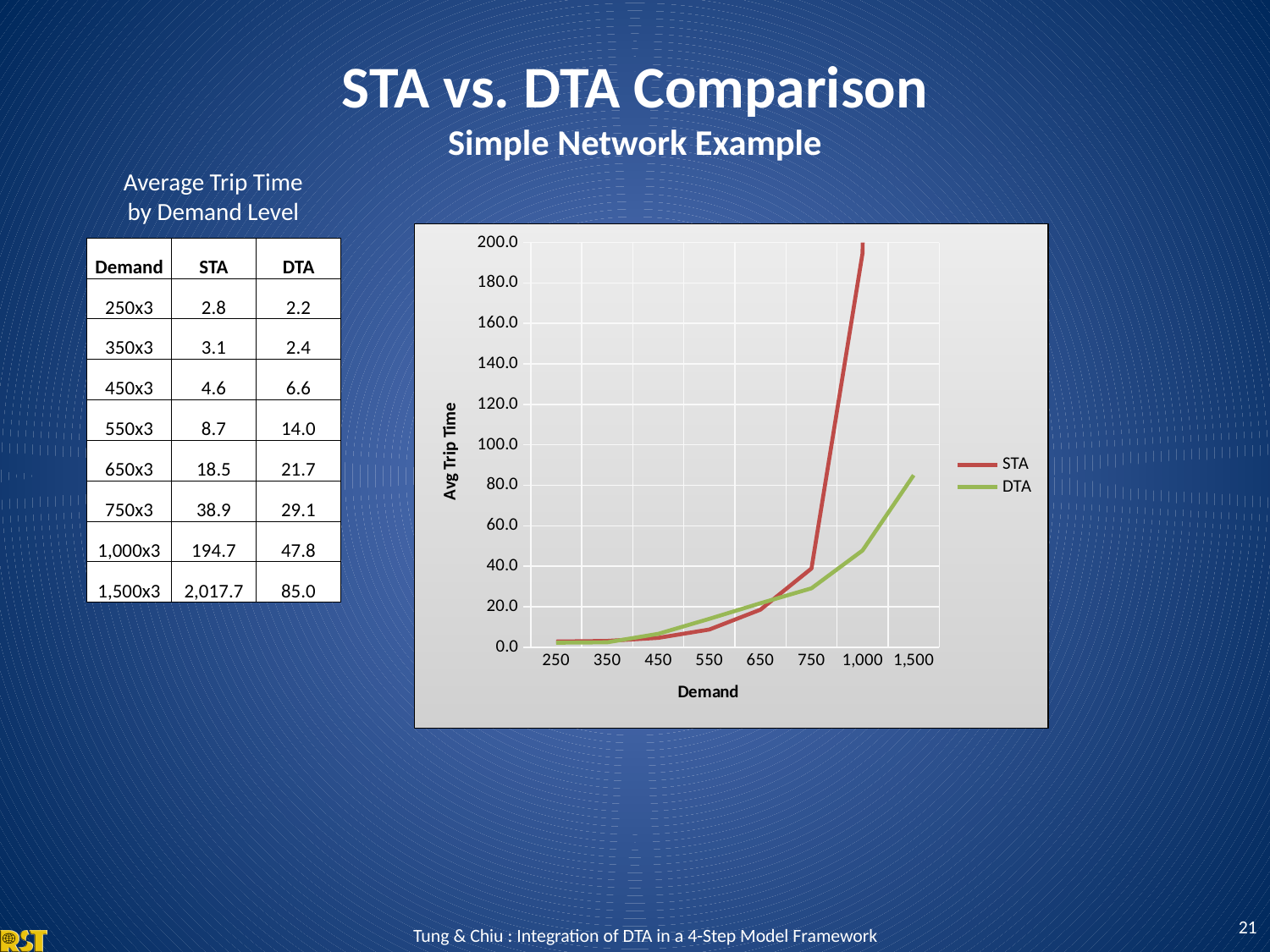
How many demand levels are marked along the chart's x axis? 8 What is the label on the chart's vertical axis? Avg Trip Time What are the two series named in the chart's legend? STA and DTA What kind of chart is shown on the slide? line chart At a demand of 1,000, which series has the higher average trip time, STA or DTA? STA At a demand of 750, which series has the higher average trip time, STA or DTA? STA How many series does the chart's legend list? 2 According to the table on the slide, what is the difference between the STA and DTA average trip times at demand level 750x3? 9.8 According to the table on the slide, what is the DTA average trip time at demand level 1,500x3? 85.0 Is the DTA value at a demand of 1,500 greater or less than 60? greater Is the STA value at a demand of 750 greater or less than 20? greater Do the STA and DTA average trip times rise or fall as demand increases along the x axis? rise